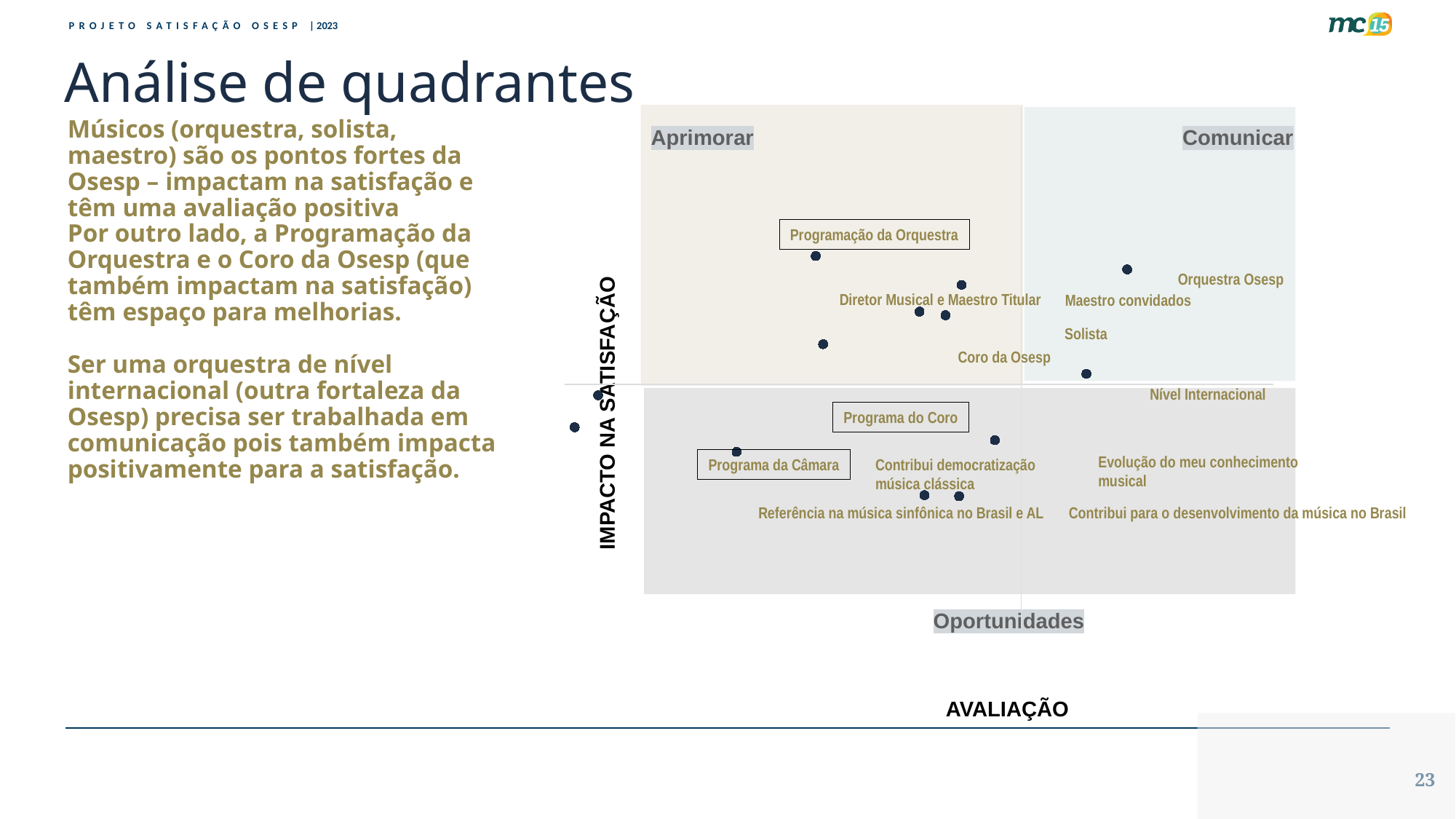
In which quadrant of the chart is the point 'Orquestra Osesp' located? Comunicar Which point has a higher impact on satisfaction, 'Coro da Osesp' or 'Referência na música sinfônica no Brasil e AL'? Coro da Osesp In which quadrant of the chart is the point 'Programa do Coro' located? Oportunidades What kind of chart is shown on the slide? Scatter chart What is the label of the horizontal axis of the chart? AVALIAÇÃO In which quadrant of the chart is the point 'Programa da Câmara' located? Oportunidades What is the label of the vertical axis of the chart? IMPACTO NA SATISFAÇÃO Which point has a higher evaluation, 'Nível Internacional' or 'Coro da Osesp'? Nível Internacional In which quadrant of the chart is the point 'Programação da Orquestra' located? Aprimorar Which point has a higher impact on satisfaction, 'Programação da Orquestra' or 'Programa do Coro'? Programação da Orquestra Which labelled point is furthest to the right on the evaluation axis? Orquestra Osesp